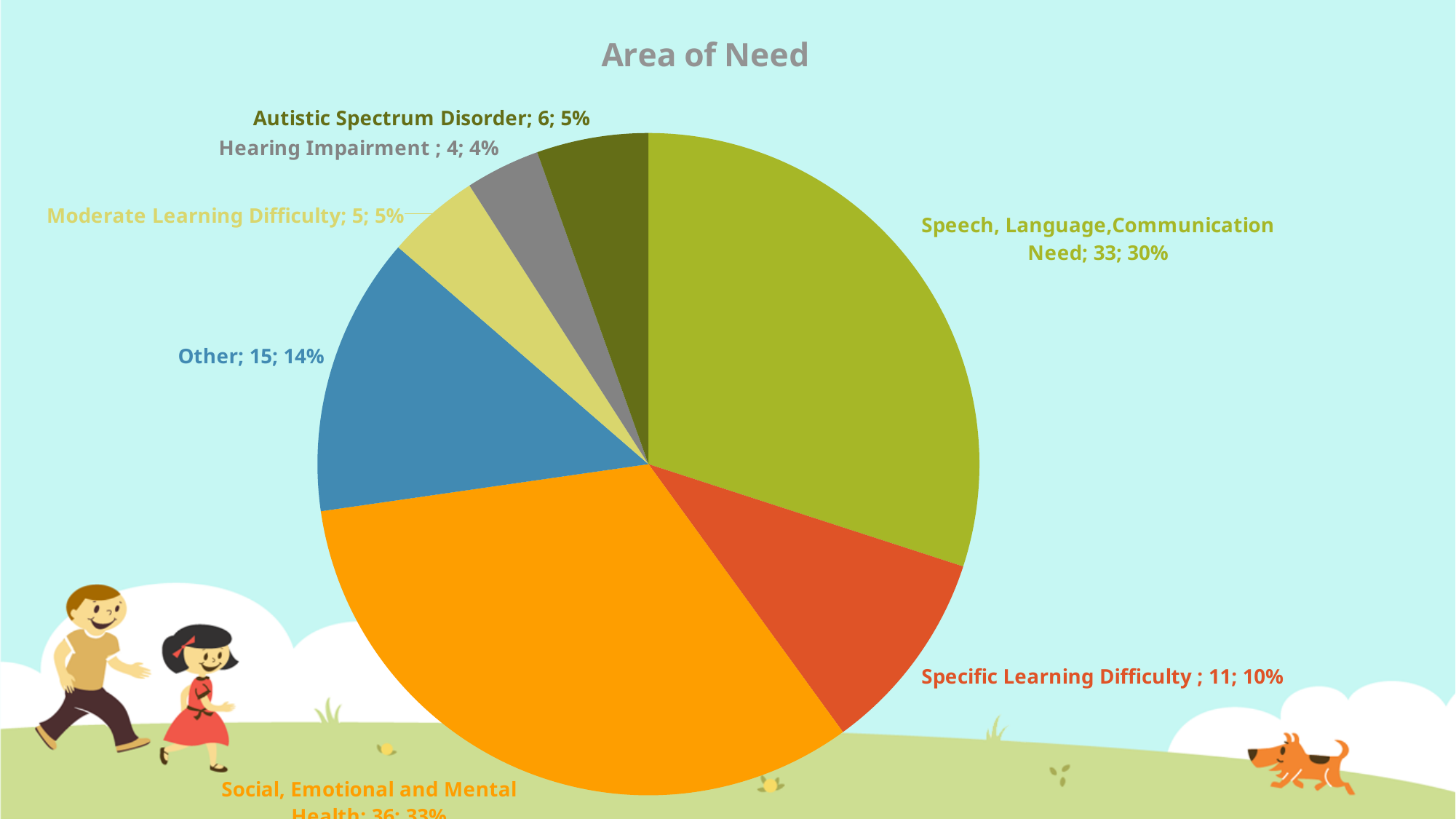
What is the difference in count between Speech, Language, Communication Need and Specific Learning Difficulty? 22 What is the count for Specific Learning Difficulty? 11 How many categories does the pie chart show? 7 What is the count for Speech, Language, Communication Need? 33 Which category has the smallest share of the pie? Hearing Impairment What kind of chart is shown on the slide? pie chart Which is larger, the count for Other or the count for Autistic Spectrum Disorder? Other What percentage share does Moderate Learning Difficulty have? 5% Which category has the largest share of the pie? Social, Emotional and Mental Health What percentage share does Other have? 14% What is the title of the chart? Area of Need What colour is the Other slice? blue